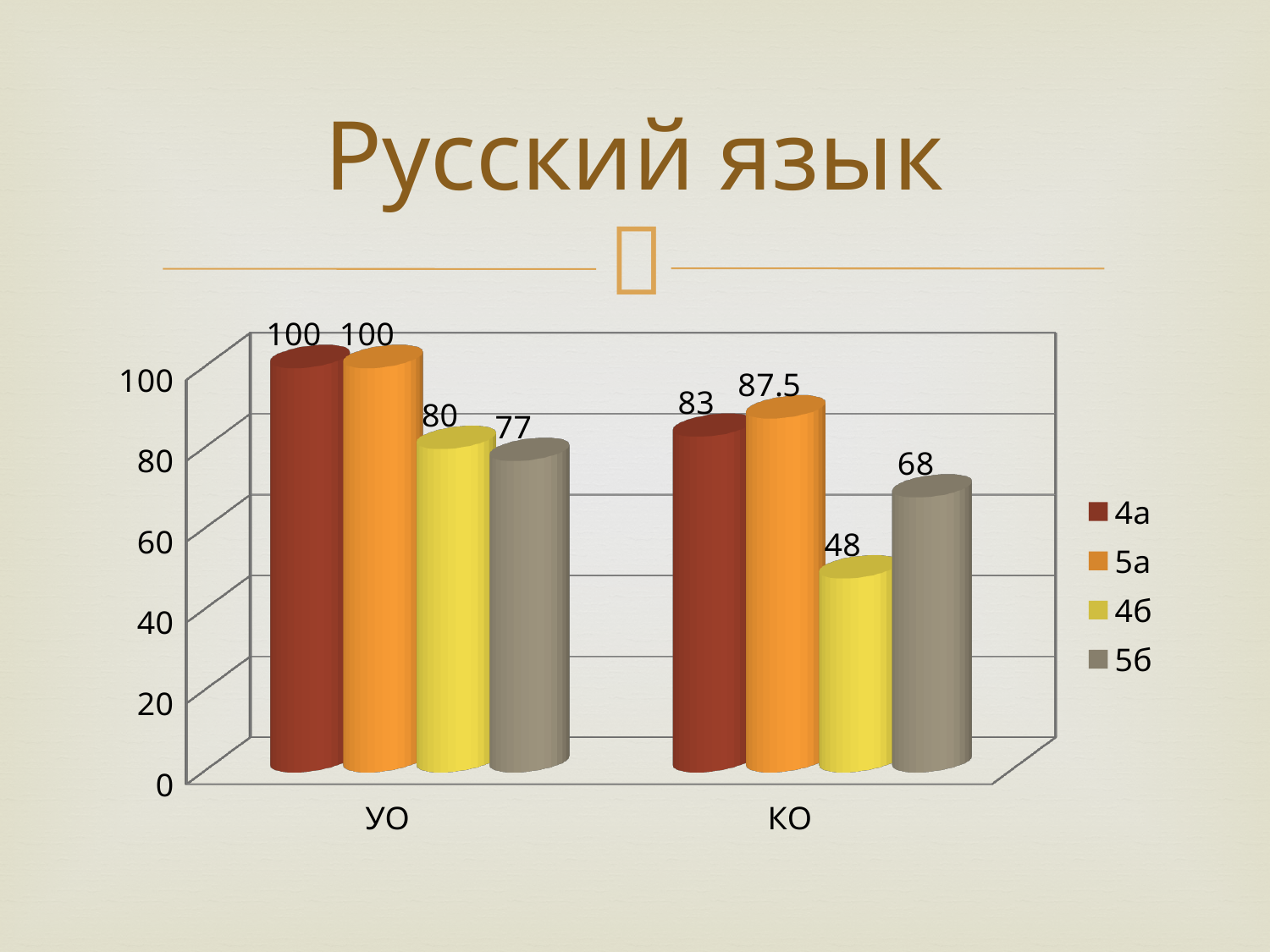
What is the difference between the 4б values for УО and КО? 32 What is the value for 5а in the КО category? 87.5 What is the value for 4б in the КО category? 48 Which series has the lowest value in the КО category? 4б How many categories are shown on the x axis? 2 What is the title of the slide? Русский язык What is the value for 5б in the УО category? 77 Which series has the highest value in the КО category? 5а What kind of chart is shown on the slide? bar chart What is the value for 4а in the УО category? 100 Which is larger: the 5б value for УО or the 5б value for КО? УО How many series does the legend list? 4